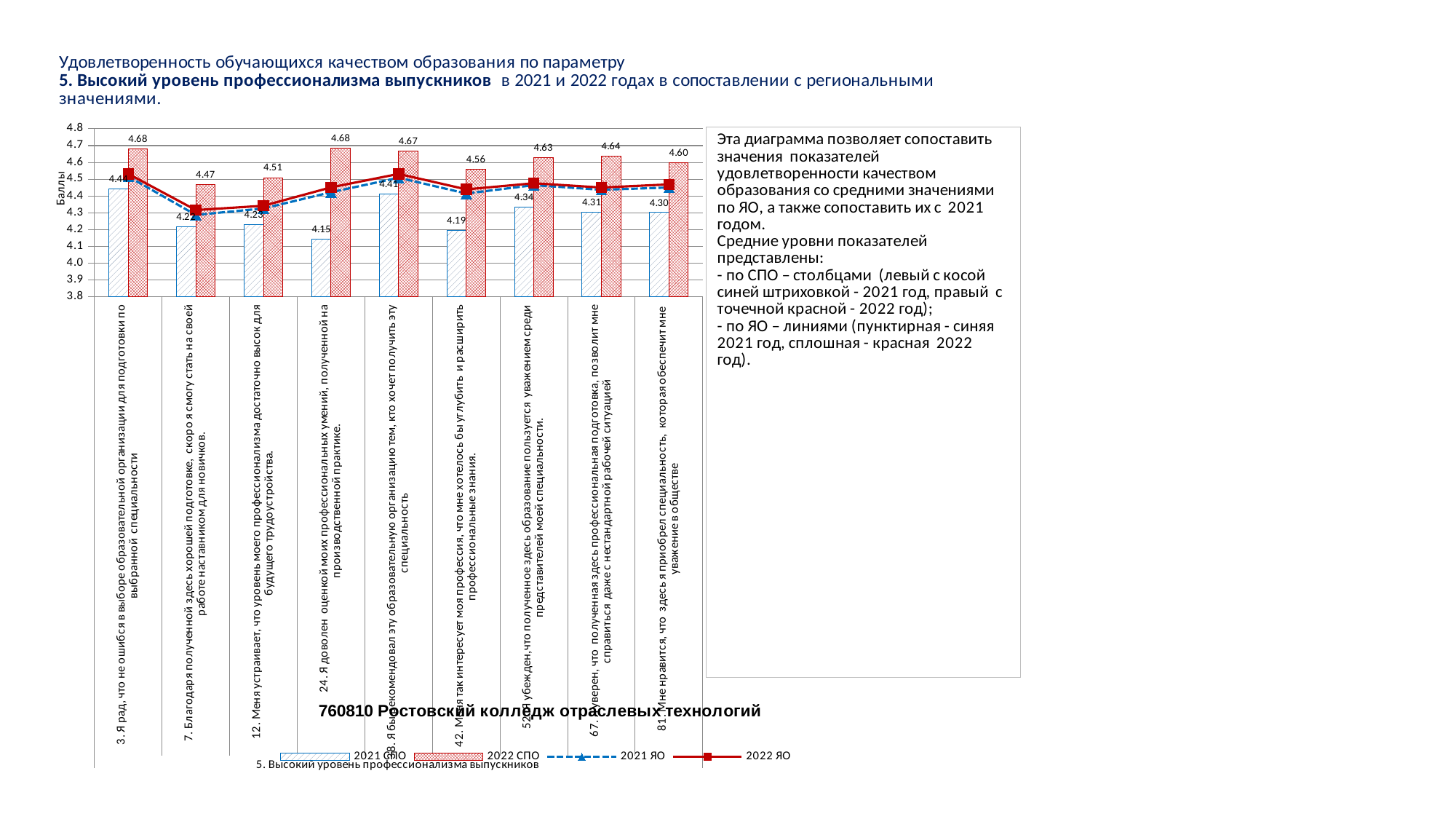
How many series does the chart legend list? 4 Which category has the lowest 2022 СПО value? 7. Благодаря полученной здесь хорошей подготовке, скоро я смогу стать на своей работе наставником для новичков (4.47) Which category has the highest 2021 СПО value? 3. Я рад, что не ошибся в выборе образовательной организации для подготовки по выбранной специальности (4.44) How many categories (statements) are shown on the x axis of the chart? 9 What is the 2021 СПО value for category 42 ("Меня так интересует моя профессия...")? 4.19 What is the 2022 СПО value for category 24 ("Я доволен оценкой моих профессиональных умений, полученной на производственной практике")? 4.68 What is the 2022 СПО value for category 81 ("Мне нравится, что здесь я приобрел специальность...")? 4.60 What is the difference between the 2022 СПО and 2021 СПО values for category 24? 0.53 Which category has the lowest 2021 СПО value? 24. Я доволен оценкой моих профессиональных умений, полученной на производственной практике (4.15) What kind of chart is shown on the slide? Combined bar and line chart Is the 2022 ЯО value for category 38 greater or less than 4.4? greater Which is larger, the 2022 СПО value for category 12 or for category 38? Category 38 (4.67)